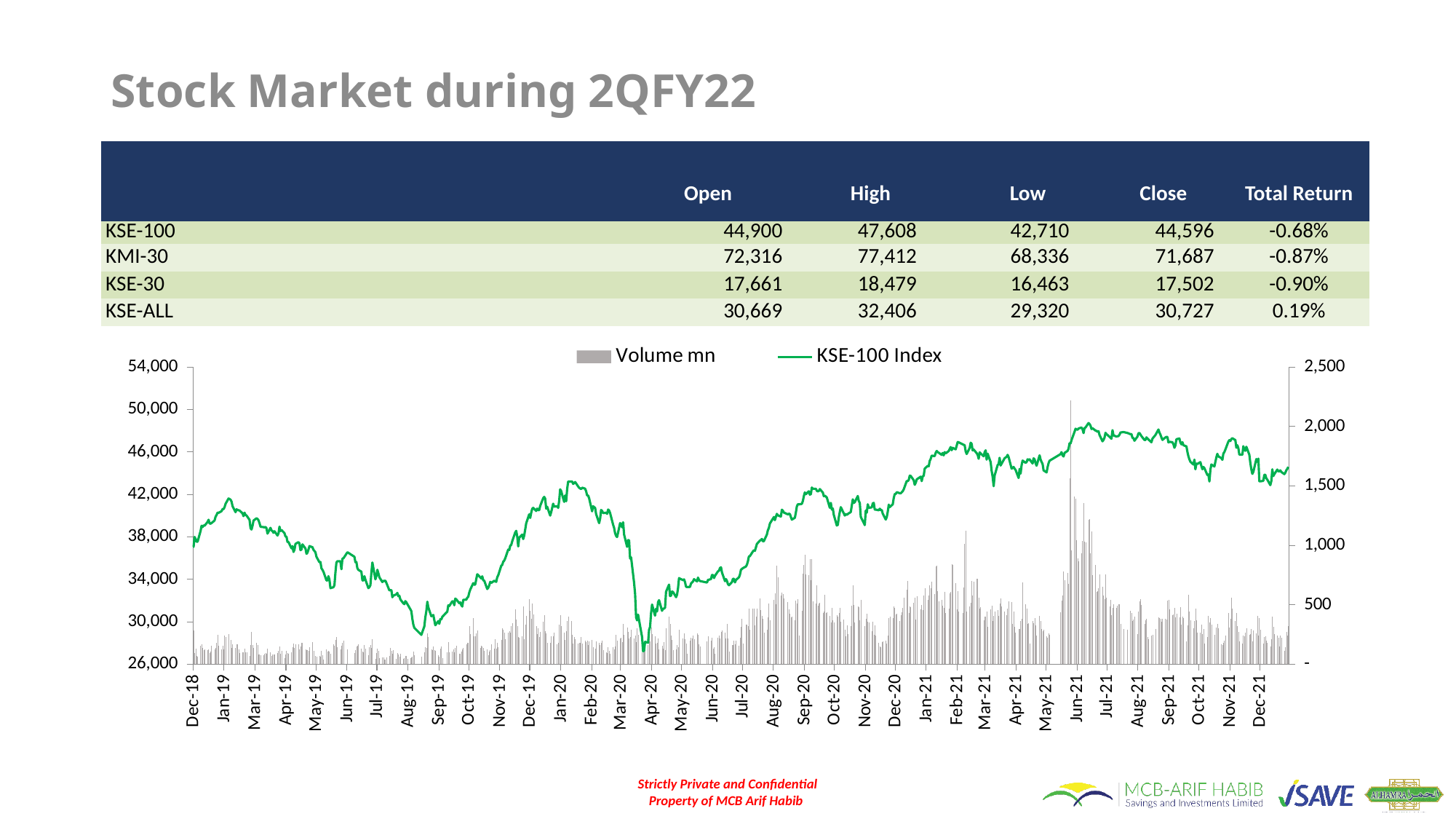
Around which month does the KSE-100 Index reach its lowest point on the chart? Mar-20 Is the highest Volume mn bar, around Jun-21, greater or less than 2,000? greater Is the peak KSE-100 Index value around Jun-21 greater or less than 46,000? greater Is the KSE-100 Index value at Dec-18 greater or less than 42,000? less Which series in the chart is drawn as grey bars? Volume mn Does the KSE-100 Index rise or fall between Apr-20 and Jun-21? rise How many series does the chart legend list? 2 What kind of chart is shown below the table on the slide? A combination bar and line chart Does the KSE-100 Index rise or fall between Jan-19 and Aug-19? fall Which series in the chart is drawn as a green line? KSE-100 Index